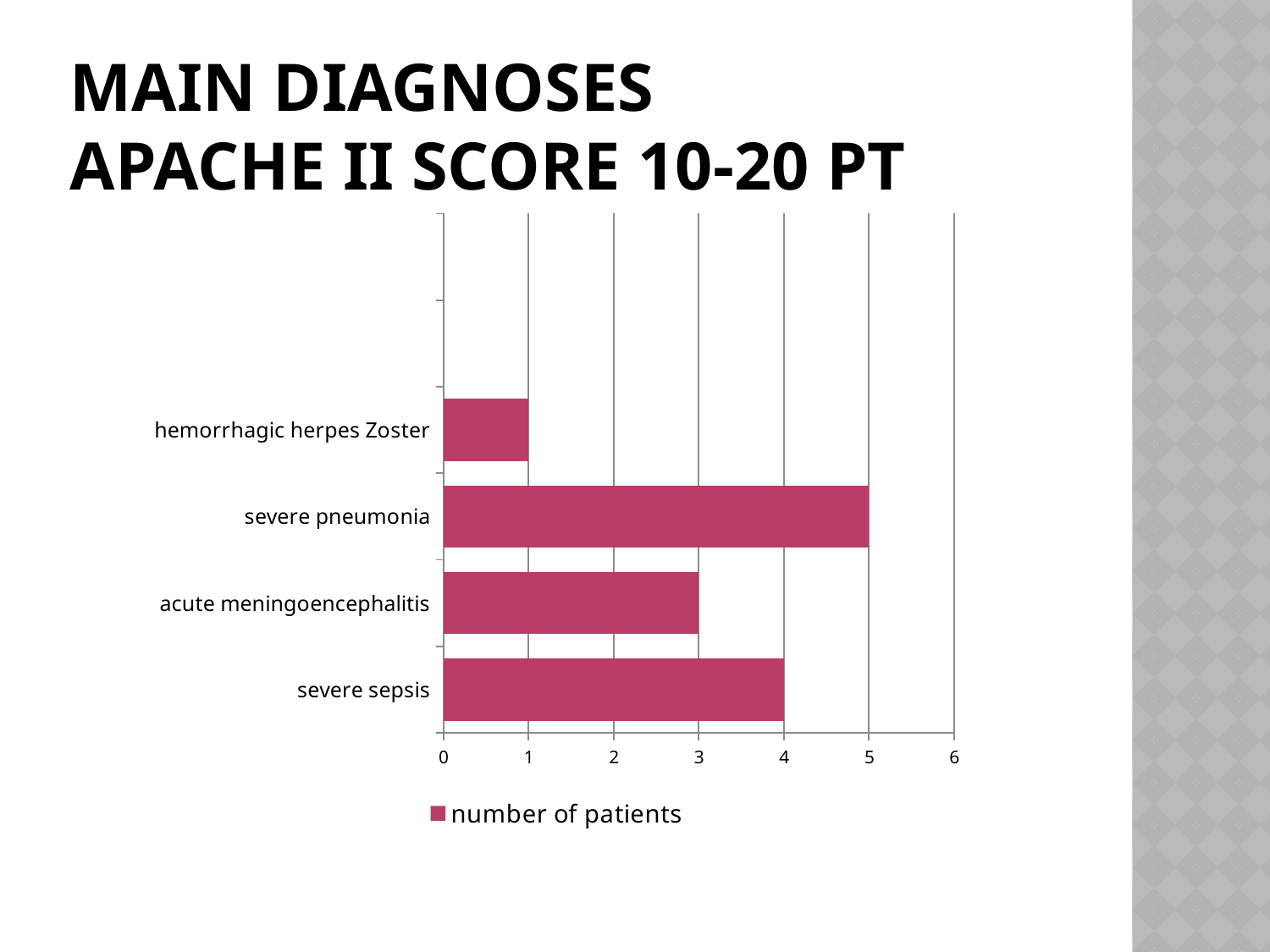
What is the number of patients for acute meningoencephalitis? 3 Which diagnosis has the lowest number of patients? hemorrhagic herpes Zoster What is the number of patients for hemorrhagic herpes Zoster? 1 What series name does the legend show? number of patients What is the number of patients for severe sepsis? 4 What is the difference in number of patients between severe pneumonia and severe sepsis? 1 How many diagnoses are labeled on the chart? 4 What kind of chart is shown on the slide? bar chart Which has more patients, severe sepsis or acute meningoencephalitis? severe sepsis What is the difference in number of patients between acute meningoencephalitis and hemorrhagic herpes Zoster? 2 Which diagnosis has the highest number of patients? severe pneumonia What is the number of patients for severe pneumonia? 5